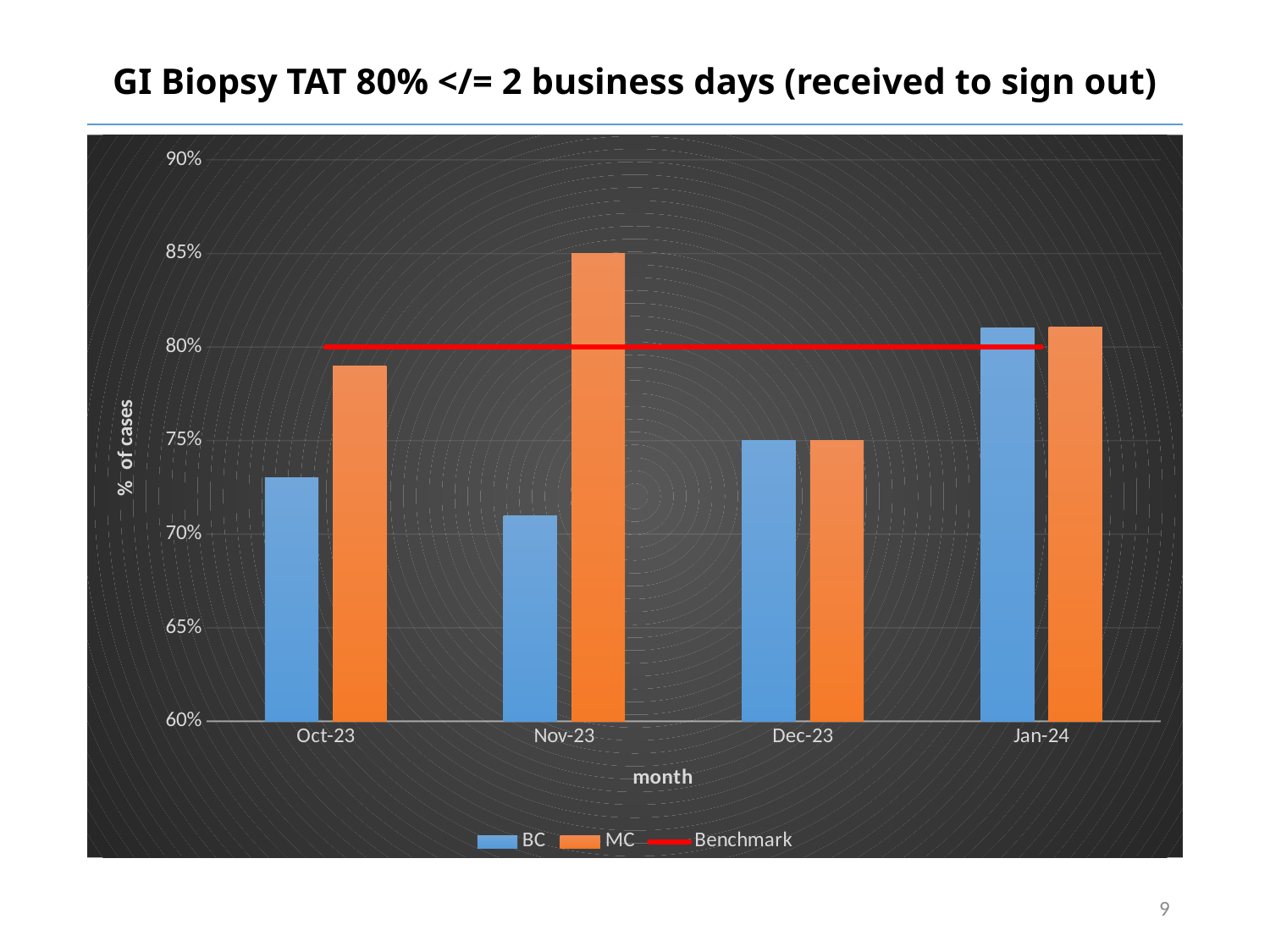
Which month has the highest MC value? Nov-23 Which month has the highest BC value? Jan-24 What type of chart is shown on the slide? combination bar and line chart Is the BC value for Oct-23 greater or less than 75%? less In Oct-23, which is larger, BC or MC? MC At what value does the Benchmark line sit? 80% What is the MC value for Dec-23? 75% How many months are shown on the x axis? 4 Which month has the lowest MC value? Dec-23 What is the BC value for Dec-23? 75% How many entries does the legend list? 3 What is the MC value for Nov-23? 85%